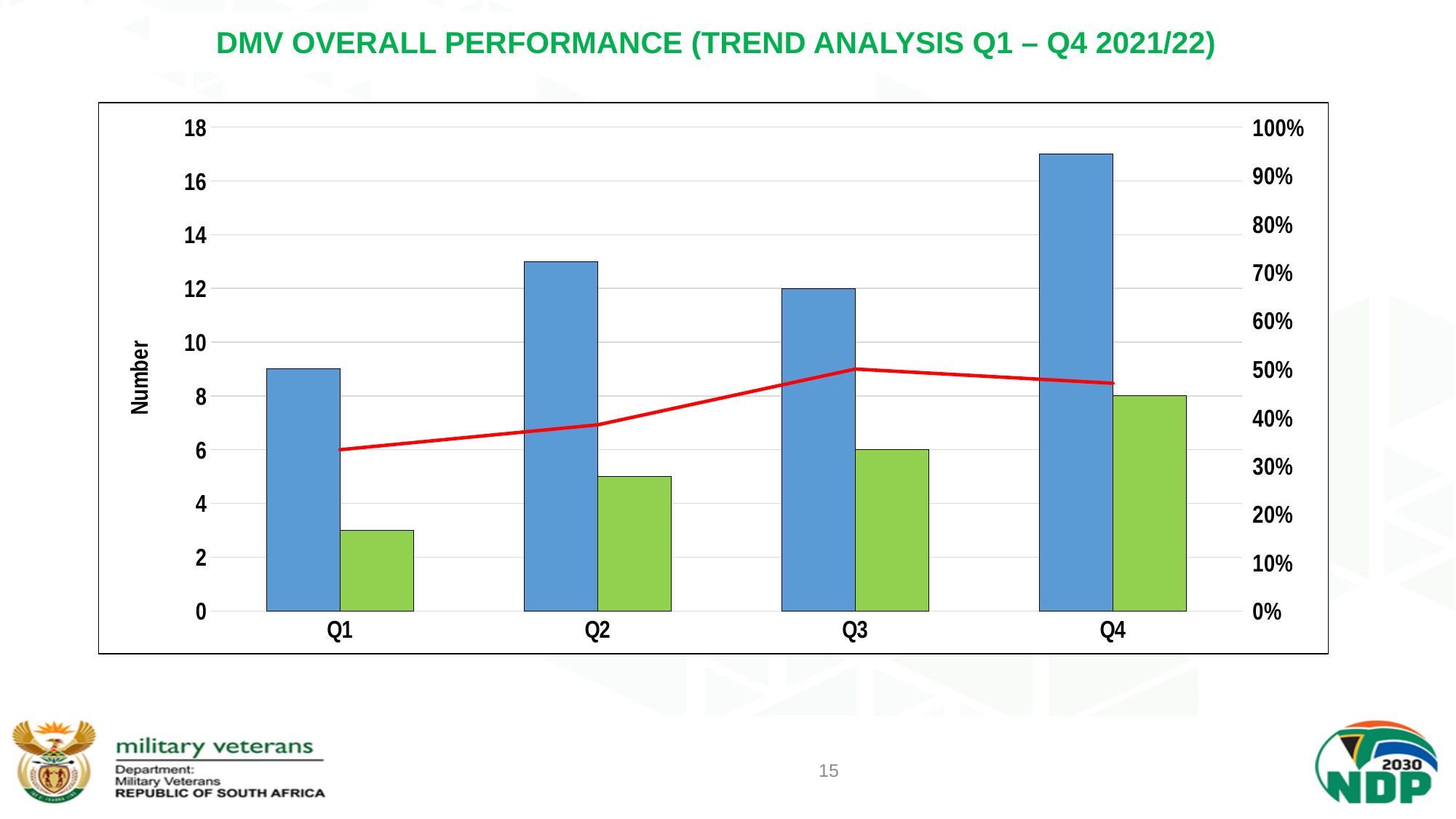
What is the value of the green bar for Q3? 6 What is the value of the blue bar for Q3? 12 Is the red line value at Q1 greater or less than 40%? less In which quarter is the green bar lowest? Q1 What is the value of the green bar for Q4? 8 What is the difference between the green bar values for Q4 and Q3? 2 How many quarters are shown on the x axis? 4 Is the value of the blue bar for Q4 greater or less than 16? greater What percentage does the red line reach at Q3 on the right-hand axis? 50% Do the green bars rise or fall from Q1 to Q4? rise Is the value of the green bar for Q1 greater or less than 4? less In which quarter is the blue bar highest? Q4